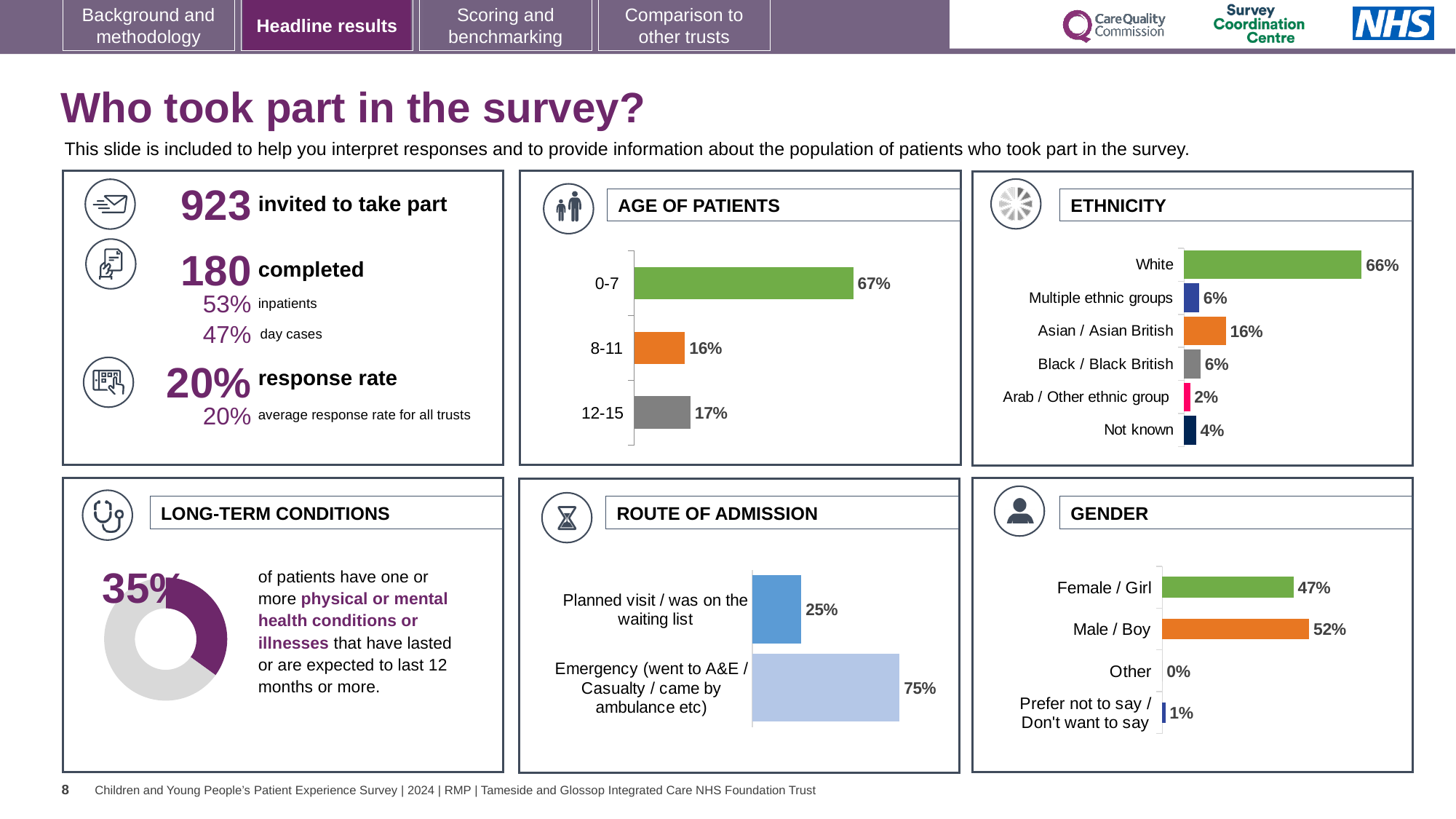
In the AGE OF PATIENTS chart, what percentage of patients are aged 0-7? 67% In the GENDER chart, what percentage of patients are Male / Boy? 52% In the ETHNICITY chart, which category has the highest percentage? White What kind of chart is used in the LONG-TERM CONDITIONS panel? Doughnut chart In the ROUTE OF ADMISSION chart, what is the difference between the Emergency and Planned visit percentages? 50% In the ETHNICITY chart, which is larger: Black / Black British or Arab / Other ethnic group? Black / Black British In the AGE OF PATIENTS chart, which age group has the lowest percentage? 8-11 In the ROUTE OF ADMISSION chart, what percentage of patients came via Emergency (went to A&E / Casualty / came by ambulance etc)? 75% In the ETHNICITY chart, how many ethnicity categories are shown? 6 In the GENDER chart, which category has the lowest percentage? Other In the ETHNICITY chart, what percentage of patients are Asian / Asian British? 16% In the AGE OF PATIENTS chart, what is the difference between the 0-7 and 12-15 percentages? 50%